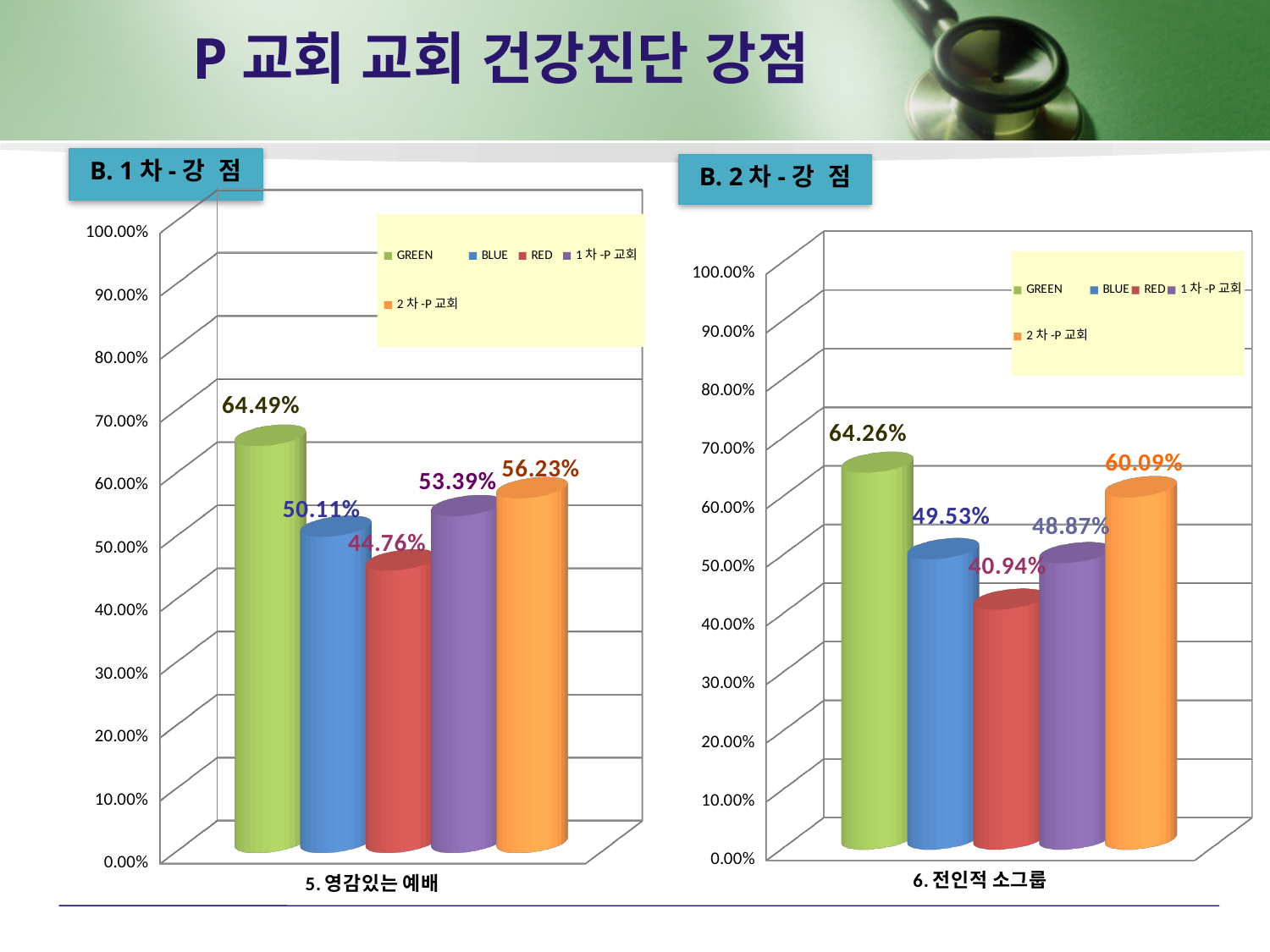
In the right chart (B. 2차 - 강점), which series has the highest value? GREEN In the left chart (B. 1차 - 강점), which series has the lowest value? RED In the right chart (B. 2차 - 강점), what is the difference between the 2차-P 교회 value and the 1차-P 교회 value? 11.22% What kind of chart is the left chart (B. 1차 - 강점)? Bar chart How many series does the legend of the right chart (B. 2차 - 강점) list? 5 In the left chart (B. 1차 - 강점), what is the difference between the GREEN value and the RED value? 19.73% In the left chart (B. 1차 - 강점), which is larger, the value for 1차-P 교회 or the value for BLUE? 1차-P 교회 In the right chart (B. 2차 - 강점), what is the value for 2차-P 교회? 60.09% In the left chart (B. 1차 - 강점), what is the value for 2차-P 교회? 56.23% What is the category label shown on the x axis of the right chart (B. 2차 - 강점)? 6. 전인적 소그룹 In the left chart (B. 1차 - 강점), what is the value for GREEN? 64.49% In the right chart (B. 2차 - 강점), what is the value for RED? 40.94%